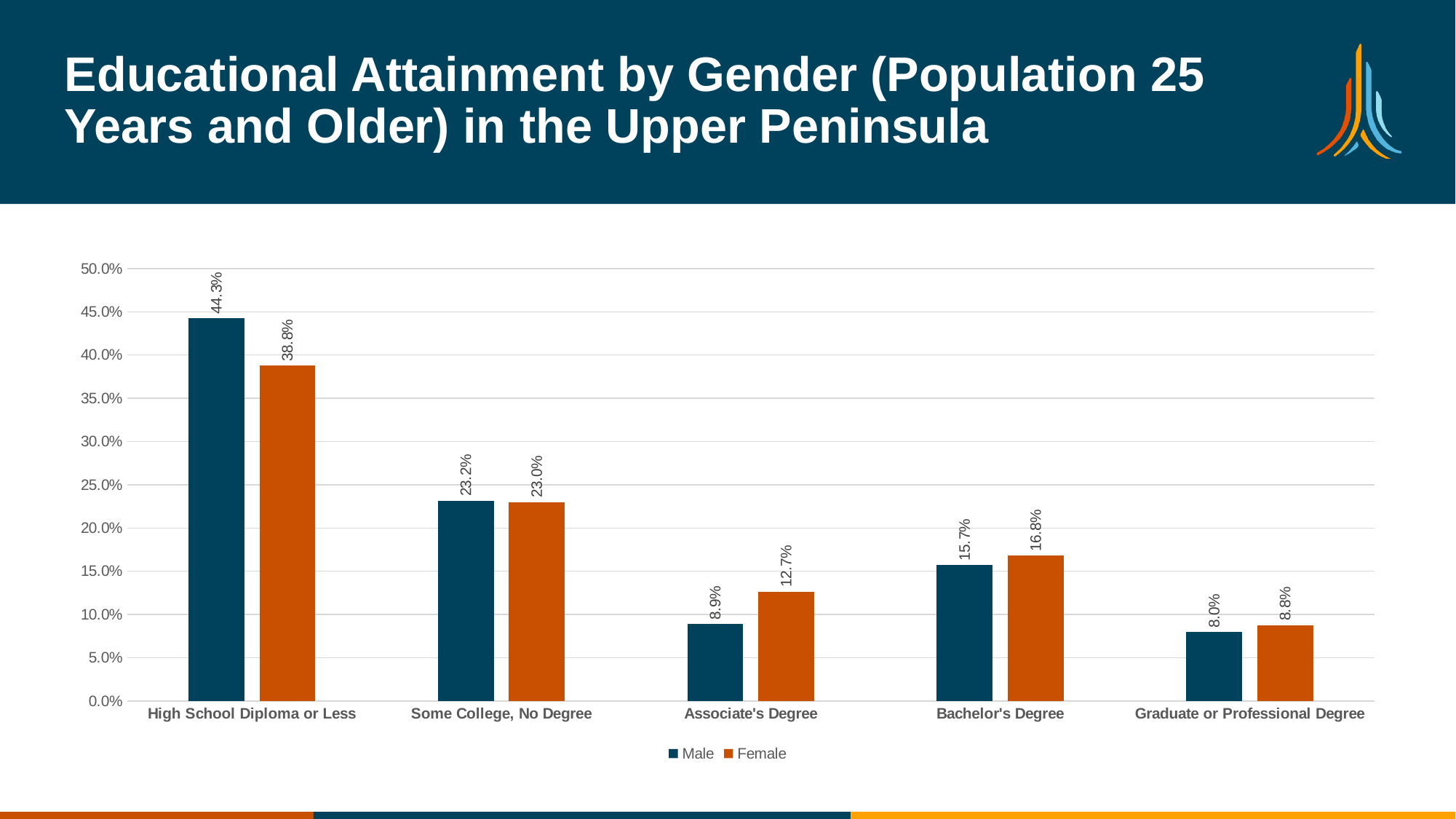
Is the Male value for Some College, No Degree greater or less than 20.0%? greater How many series does the legend list? 2 Which is larger for Bachelor's Degree, the Male value or the Female value? Female What is the Female value for Associate's Degree? 12.7% What is the Male value for High School Diploma or Less? 44.3% What kind of chart is shown on the slide? Bar chart How many education categories are shown on the x axis? 5 What is the Female value for Graduate or Professional Degree? 8.8% Which category has the lowest Male value? Graduate or Professional Degree Which category has the highest Female value? High School Diploma or Less What is the difference between the Female and Male values for Associate's Degree? 3.8% What is the difference between the Male and Female values for High School Diploma or Less? 5.5%